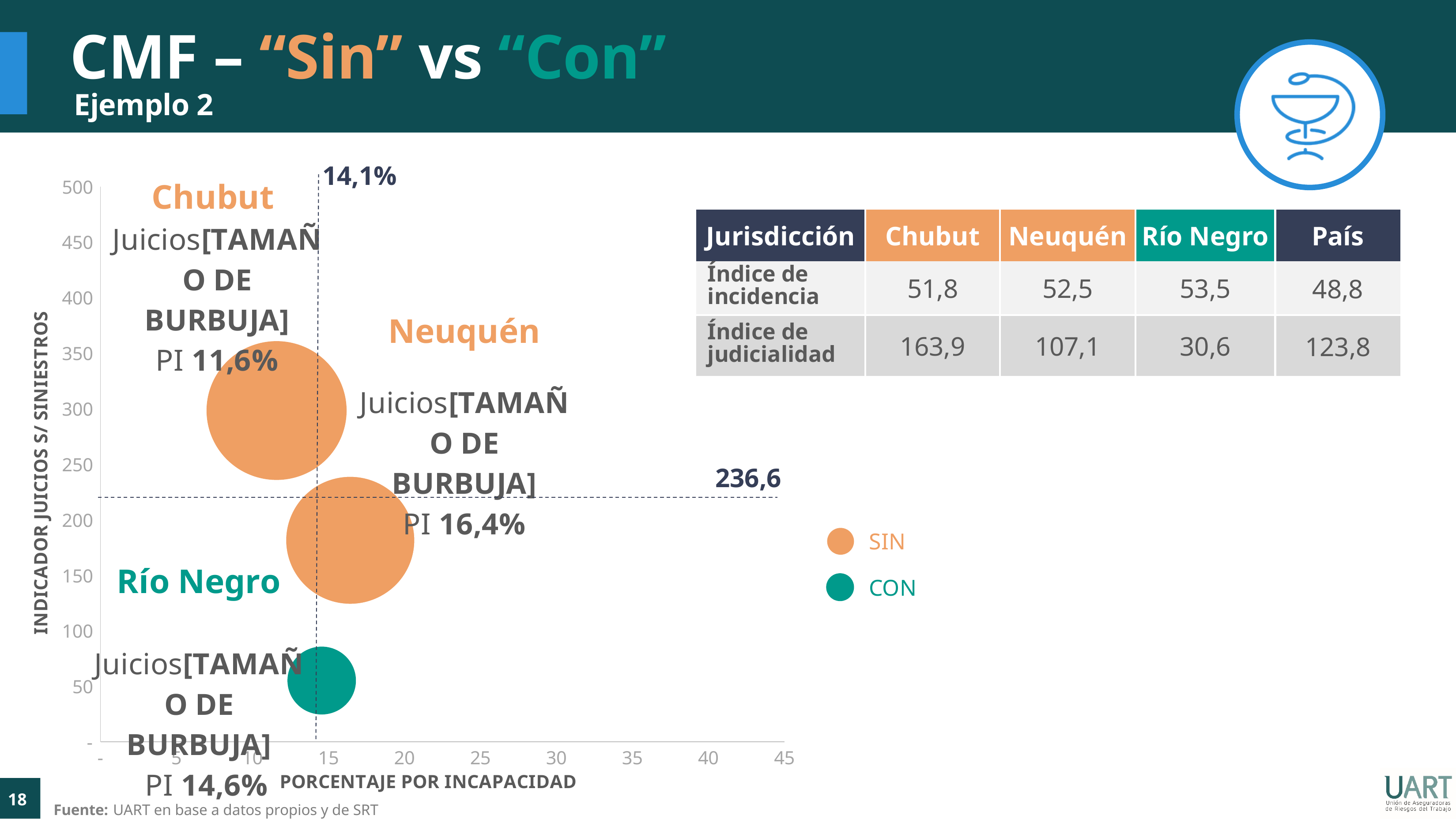
Which jurisdiction has the highest PI value in the chart? Neuquén Which jurisdiction is plotted in the CON series (green bubble)? Río Negro How many series does the chart legend list? 2 What is the difference between the PI values of Neuquén and Chubut? 4,8% What is the PI value shown for Neuquén? 16,4% Which jurisdiction has the lowest PI value in the chart? Chubut Is the indicador juicios s/ siniestros value for Río Negro greater or less than 100? less How many jurisdictions are plotted as bubbles in the chart? 3 What is the PI value shown for Río Negro? 14,6% Is the indicador juicios s/ siniestros value for Chubut greater or less than 250? greater What is the PI (porcentaje por incapacidad) value shown for Chubut? 11,6% What kind of chart is shown on the slide? bubble chart